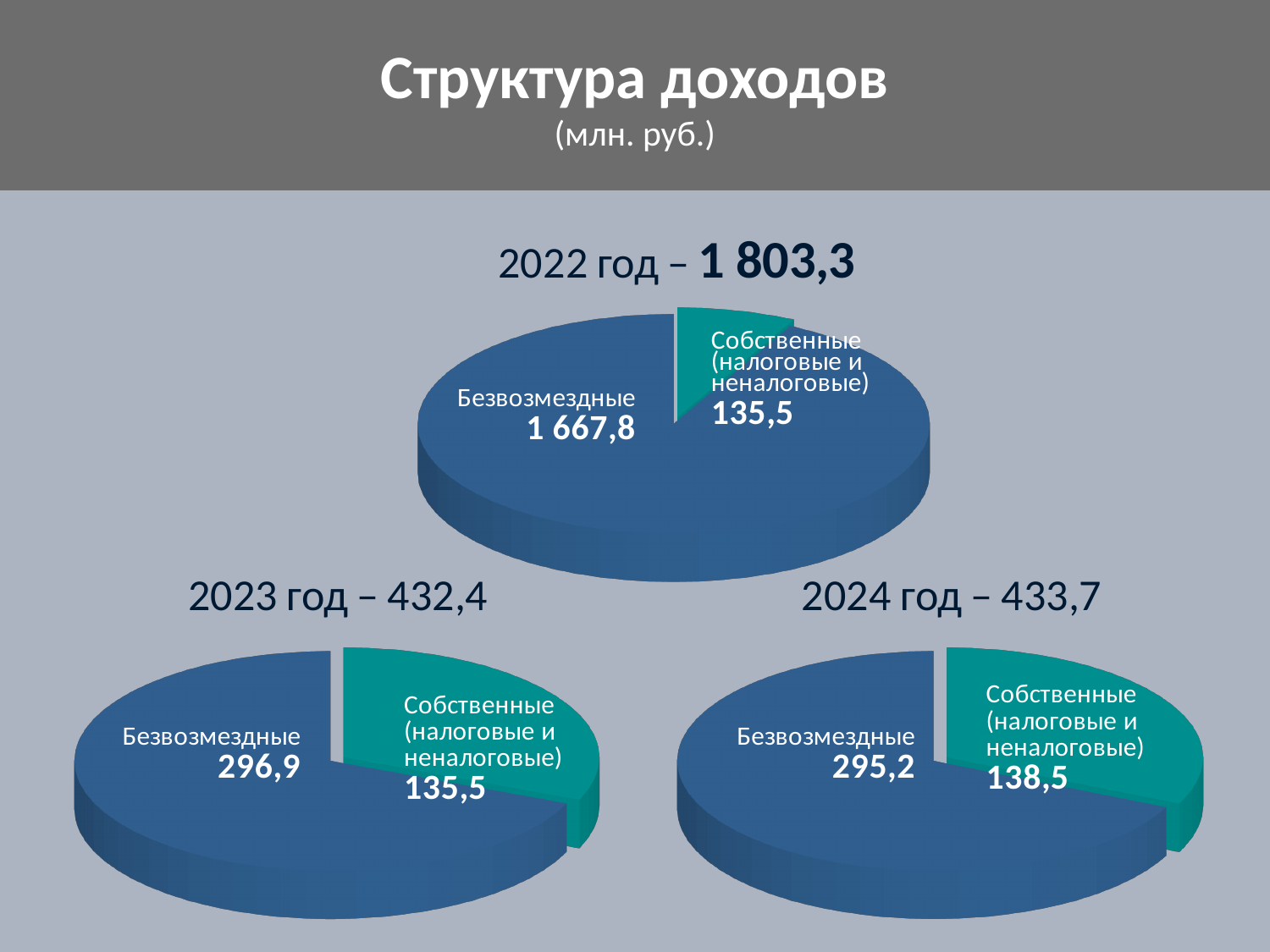
What total is shown for 2024 год? 433,7 In the 2022 год chart, what is the value for Собственные (налоговые и неналоговые)? 135,5 How many pie charts are on the slide? 3 What unit is given under the slide title Структура доходов? млн. руб. Which is larger: Безвозмездные in the 2023 год chart or Безвозмездные in the 2024 год chart? 2023 год (296,9) What type of charts are shown on the slide? Pie charts In the 2023 год chart, which category has the largest slice? Безвозмездные In the 2024 год chart, what is the value for Собственные (налоговые и неналоговые)? 138,5 In the 2024 год chart, what is the difference between Безвозмездные and Собственные (налоговые и неналоговые)? 156,7 In the 2023 год chart, what is the value for Безвозмездные? 296,9 In the 2022 год chart, which category has the smallest slice? Собственные (налоговые и неналоговые) In the 2022 год chart, what is the value for Безвозмездные? 1 667,8